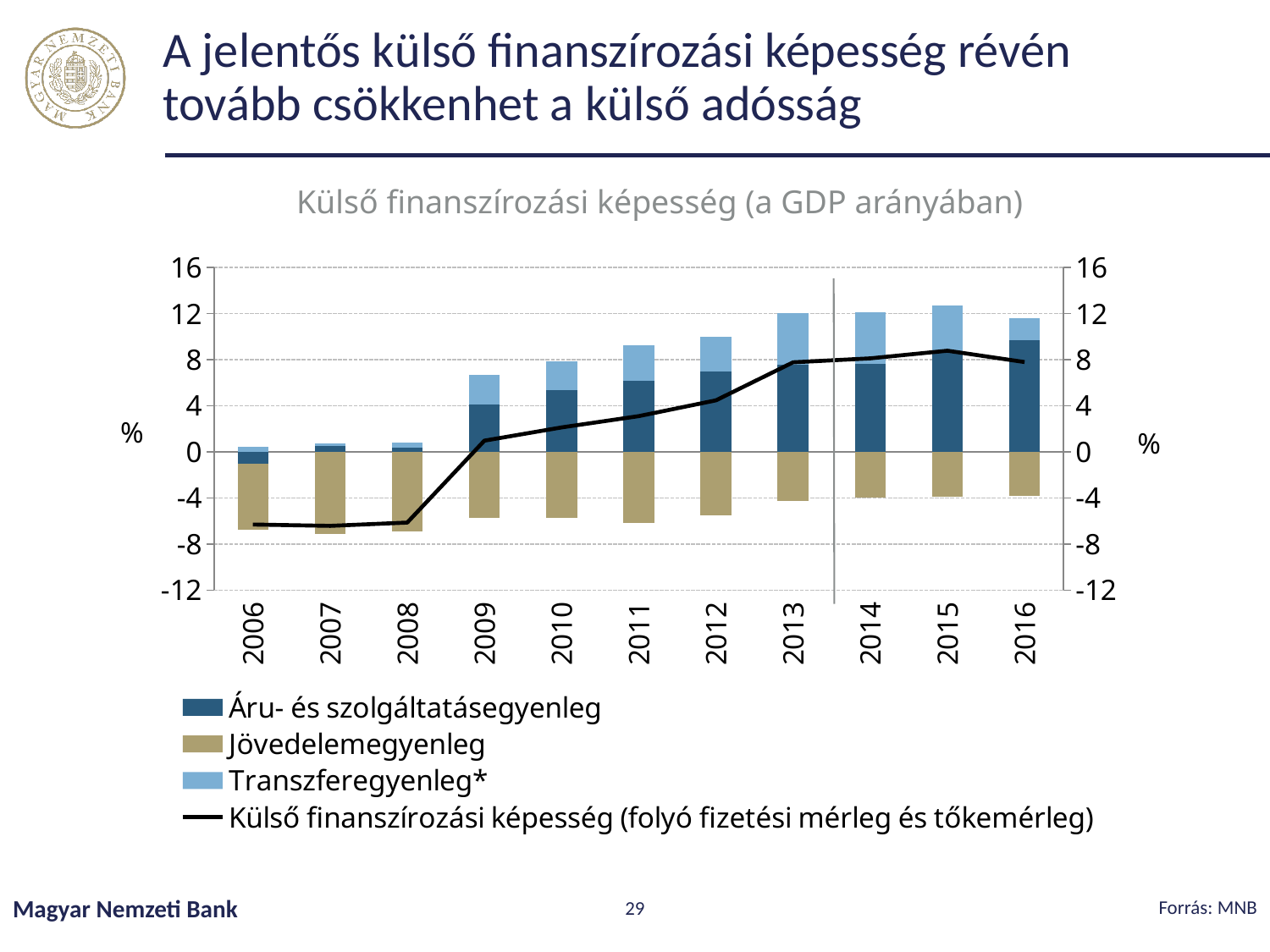
Does the Külső finanszírozási képesség line generally rise or fall from 2006 to 2015? Rise Is the value for Jövedelemegyenleg in 2012 greater or less than -4? less Which year has the highest value for the Külső finanszírozási képesség line? 2015 Which year has the highest value for Áru- és szolgáltatásegyenleg? 2016 What is the title of the chart? Külső finanszírozási képesség (a GDP arányában) How many years are shown on the x axis? 11 Is the value of the Külső finanszírozási képesség line in 2006 greater or less than -4? less How many series does the legend list? 4 Which is larger, the Külső finanszírozási képesség line value in 2013 or in 2006? 2013 What kind of chart is shown on the slide? A stacked bar chart combined with a line Is the value of the Külső finanszírozási képesség line in 2013 greater or less than 4? greater